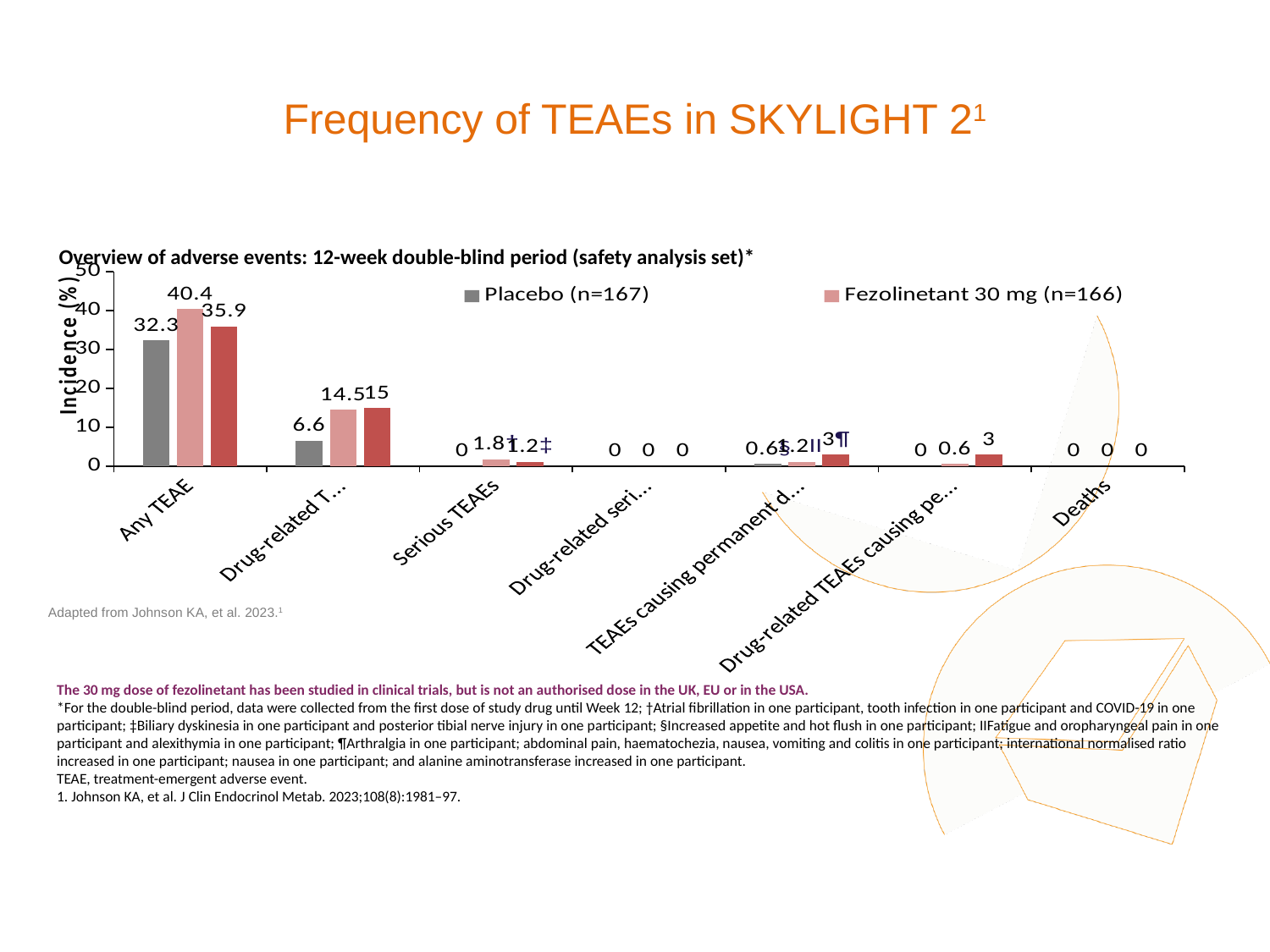
How many categories are shown on the x axis of the chart? 7 Which category has the highest incidence for Placebo (n=167)? Any TEAE For Any TEAE, which has the higher incidence: Placebo (n=167) or Fezolinetant 30 mg (n=166)? Fezolinetant 30 mg (n=166) What is the label of the y axis of the chart? Incidence (%) What is the incidence of Drug-related TEAEs for Placebo (n=167)? 6.6 What kind of chart is shown on the slide? Bar chart What is the incidence of Deaths for Placebo (n=167)? 0 What is the difference in Any TEAE incidence between Fezolinetant 30 mg (n=166) and Placebo (n=167)? 8.1 What is the incidence of Drug-related TEAEs for Fezolinetant 30 mg (n=166)? 14.5 What is the incidence of Any TEAE for Placebo (n=167)? 32.3 What is the incidence of Any TEAE for Fezolinetant 30 mg (n=166)? 40.4 Is the Placebo (n=167) value for Drug-related TEAEs greater or less than 10? less